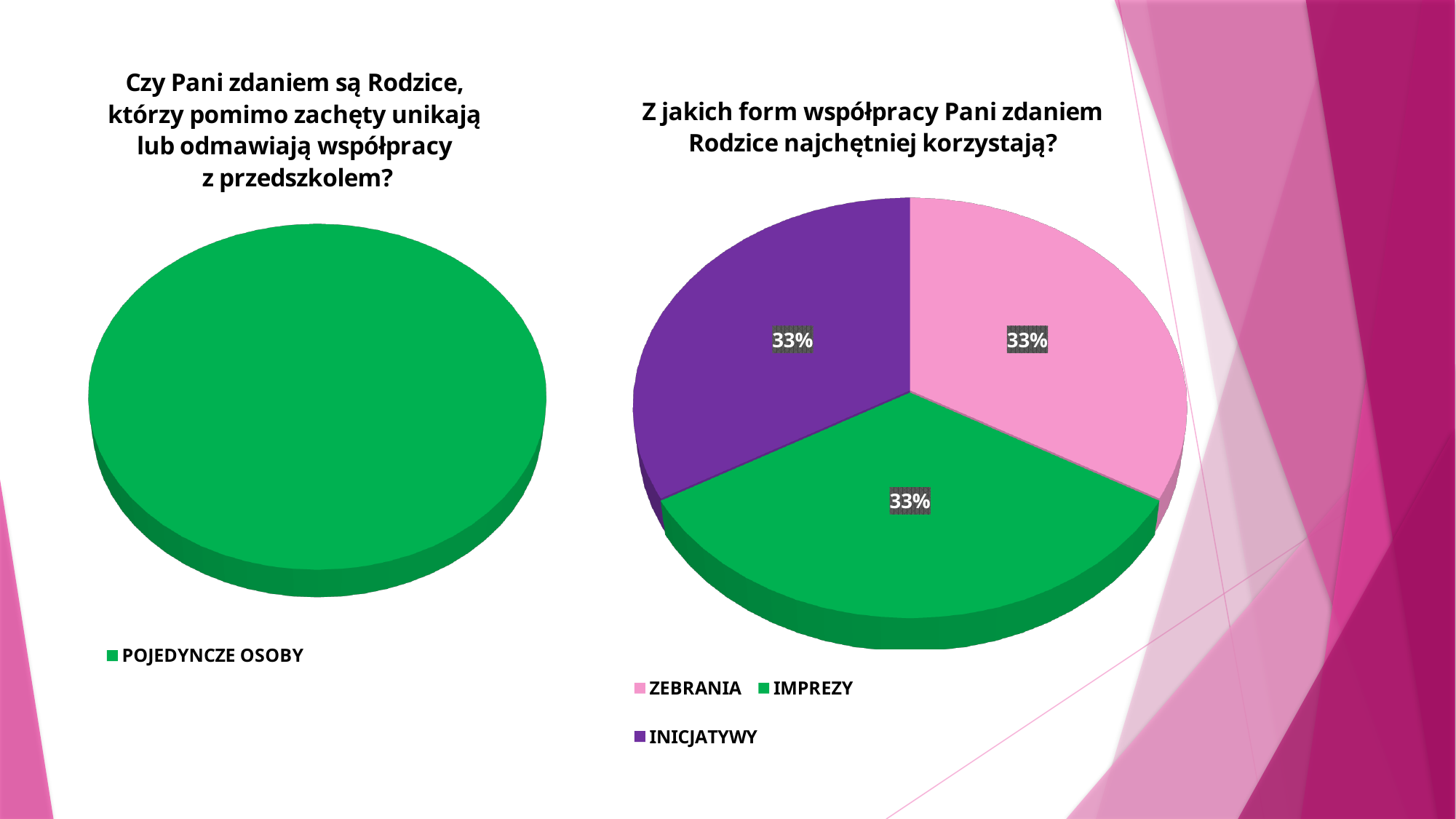
In the chart on the right, what share of the pie does ZEBRANIA have? 33% What kind of chart is the chart on the left of the slide? pie chart What is the only legend entry of the chart on the left? POJEDYNCZE OSOBY In the chart on the right, what is the value shown for IMPREZY? 33% How many slices does the chart on the right have? 3 How many entries does the legend of the chart on the right list? 3 What kind of chart is the chart titled 'Z jakich form współpracy Pani zdaniem Rodzice najchętniej korzystają?'? pie chart In the chart on the right, which category is shown in purple? INICJATYWY How many entries does the legend of the chart on the left list? 1 In the chart on the right, what is the difference between the values for ZEBRANIA and INICJATYWY? 0% In the chart on the right, what is the value shown for INICJATYWY? 33%